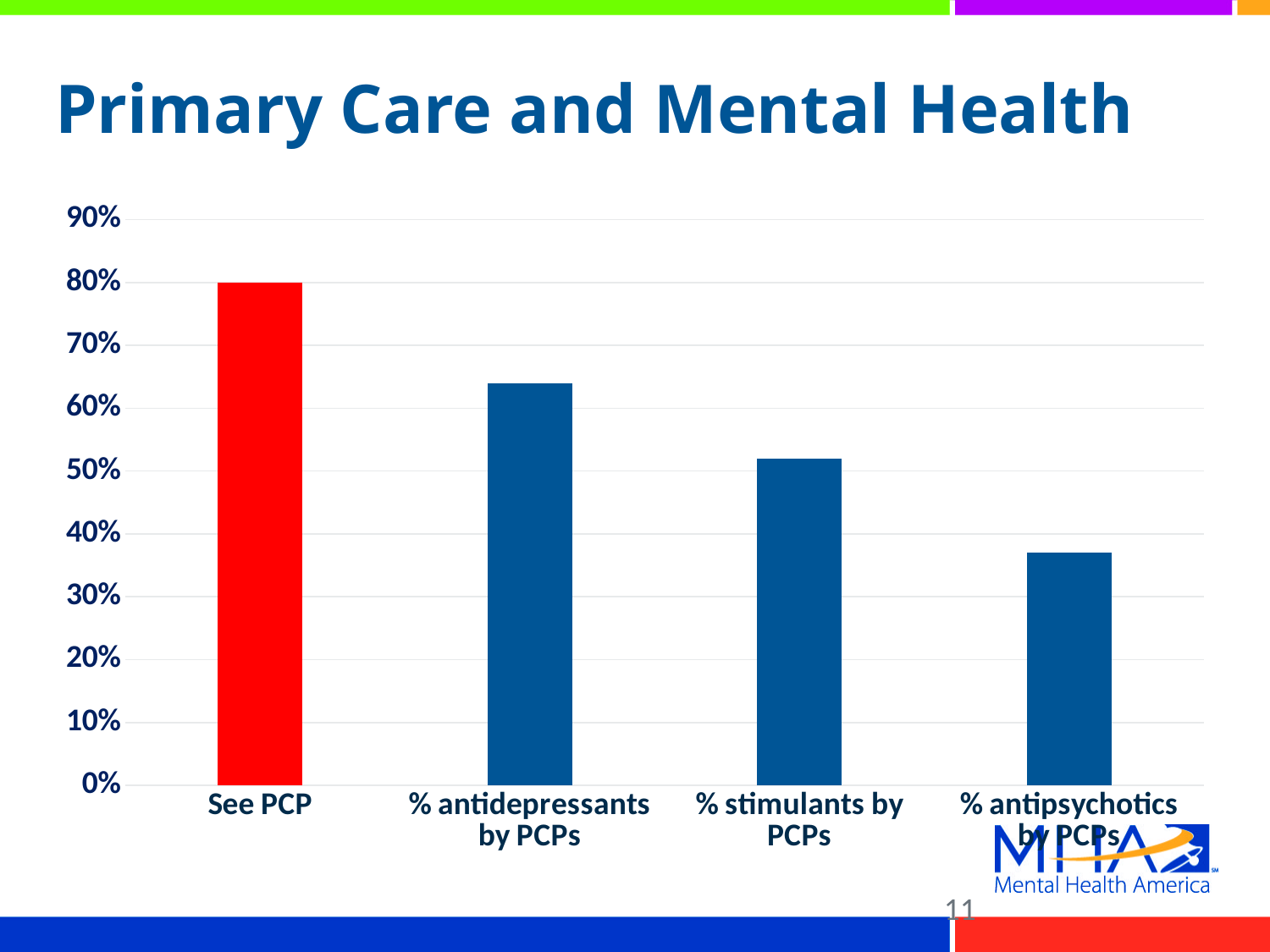
How many bars are plotted in the chart? 4 Do the bar values rise or fall from left to right across the categories? fall What is the title of the slide containing the chart? Primary Care and Mental Health Is the value for % antidepressants by PCPs greater or less than 60%? greater Is the value for % antipsychotics by PCPs greater or less than 40%? less What is the value for See PCP? 80% What kind of chart is shown on the slide? bar chart Which category has the lowest value? % antipsychotics by PCPs Which category has the highest value? See PCP Which is larger, the value for % antidepressants by PCPs or the value for % stimulants by PCPs? % antidepressants by PCPs Is the value for % stimulants by PCPs greater or less than 60%? less Which bar is coloured red rather than blue? See PCP